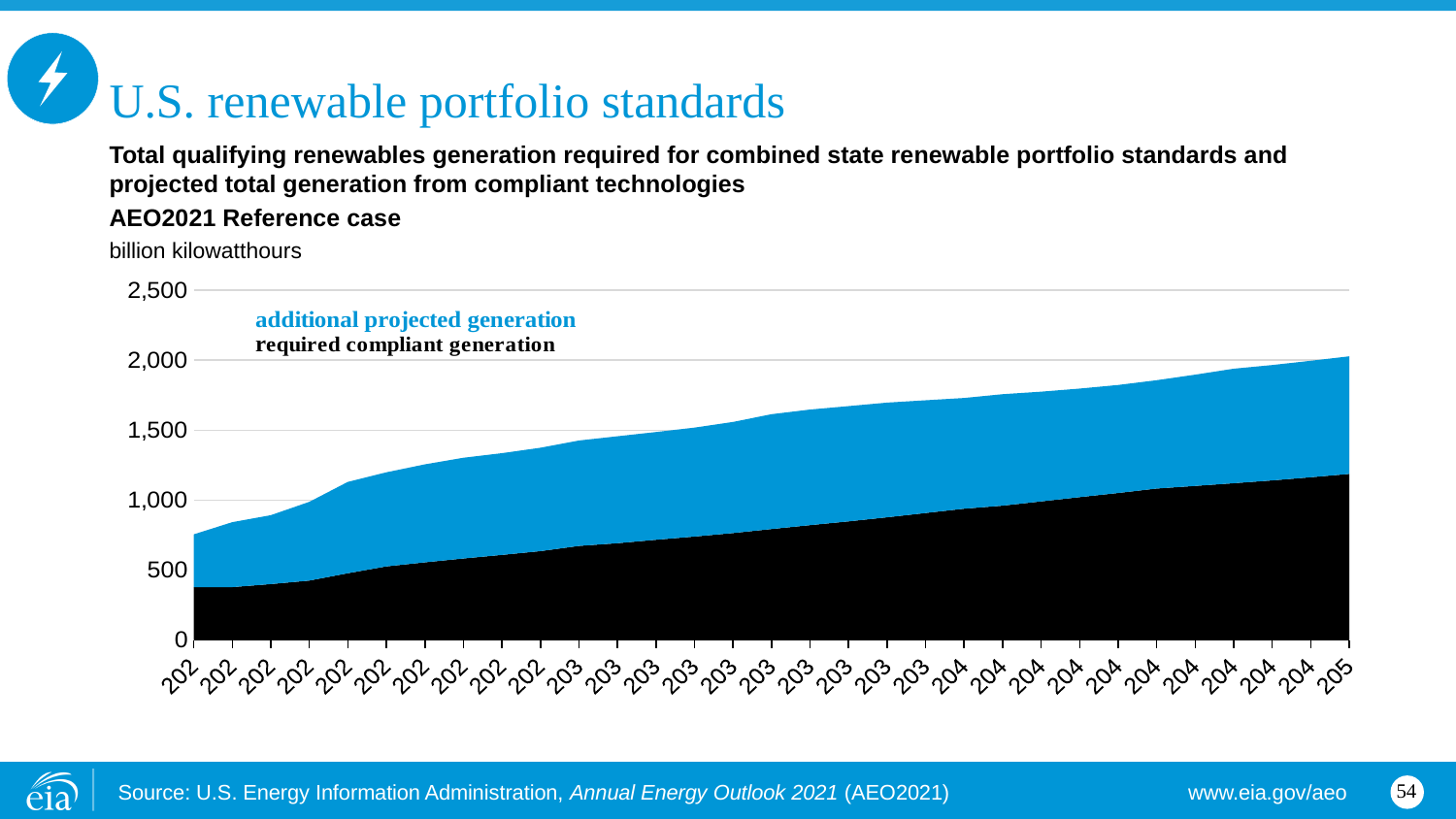
What kind of chart is shown on the slide? area chart How many series does the chart's legend list? 2 What unit is the chart's y axis measured in? billion kilowatthours Is required compliant generation at the leftmost point of the chart greater or less than 500? less Does required compliant generation rise or fall from left to right along the x axis? rise What are the two series named in the chart's legend? additional projected generation; required compliant generation Which series is drawn in blue? additional projected generation At the rightmost point of the chart, which series is larger: required compliant generation or additional projected generation? required compliant generation Does the total stacked generation rise or fall from left to right along the x axis? rise Is required compliant generation at the rightmost point of the chart greater or less than 1,000? greater Is the total stacked value at the leftmost point of the chart greater or less than 1,000? less